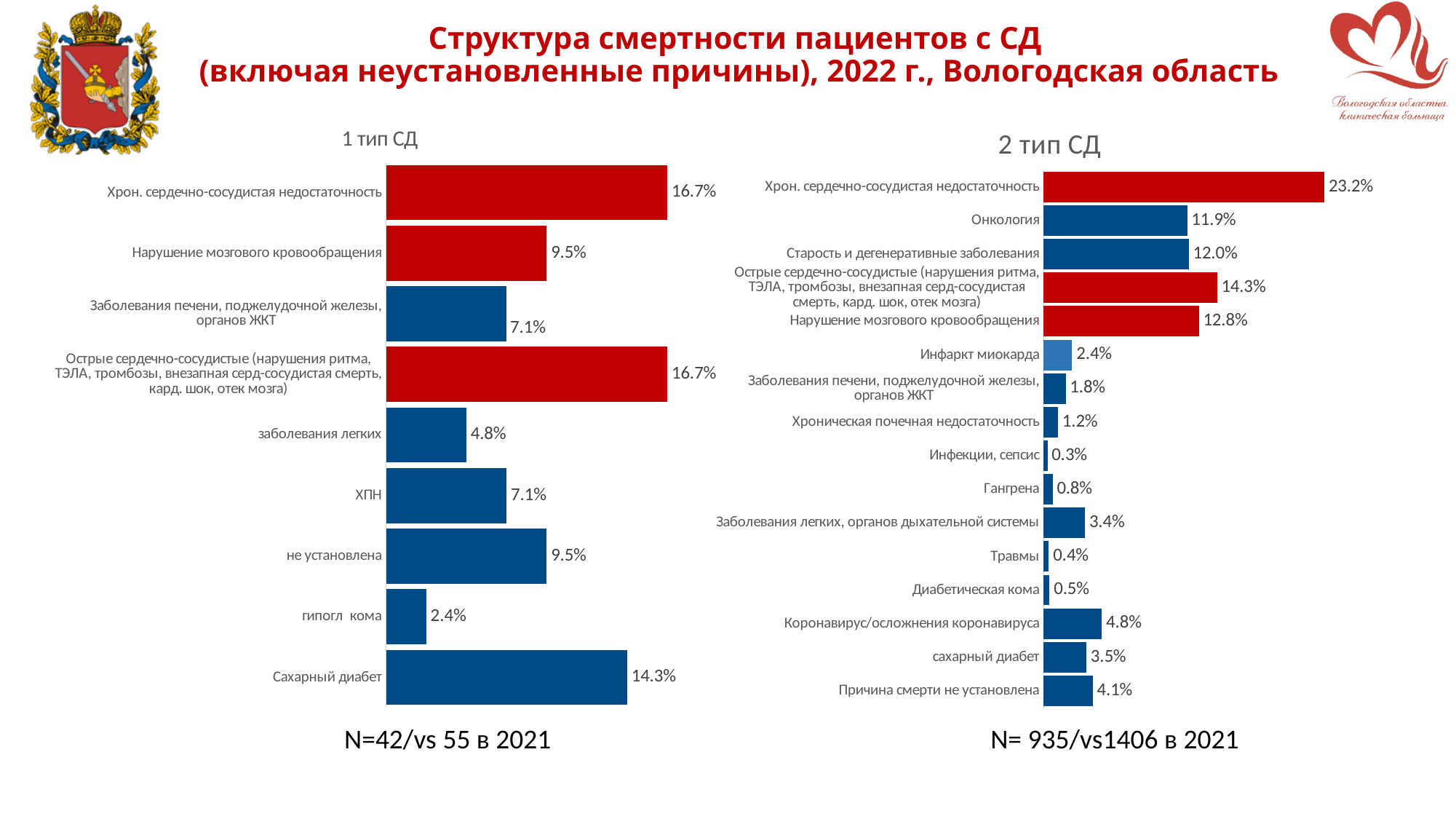
In the "2 тип СД" chart, which category has the highest value? Хрон. сердечно-сосудистая недостаточность In the "2 тип СД" chart, which is larger: Коронавирус/осложнения коронавируса or сахарный диабет? Коронавирус/осложнения коронавируса In the "1 тип СД" chart, which category has the lowest value? гипогл кома In the "1 тип СД" chart, what is the value for Сахарный диабет? 14.3% In the "1 тип СД" chart, which is larger: Нарушение мозгового кровообращения or ХПН? Нарушение мозгового кровообращения In the "2 тип СД" chart, which category has the lowest value? Инфекции, сепсис In the "2 тип СД" chart, what is the value for Онкология? 11.9% In the "2 тип СД" chart, what is the difference between Хрон. сердечно-сосудистая недостаточность and Нарушение мозгового кровообращения? 10.4% What type of chart is the "2 тип СД" chart? Bar chart In the "1 тип СД" chart, what is the difference between Сахарный диабет and заболевания легких? 9.5% In the "2 тип СД" chart, how many categories are shown? 16 In the "1 тип СД" chart, how many categories are shown? 9